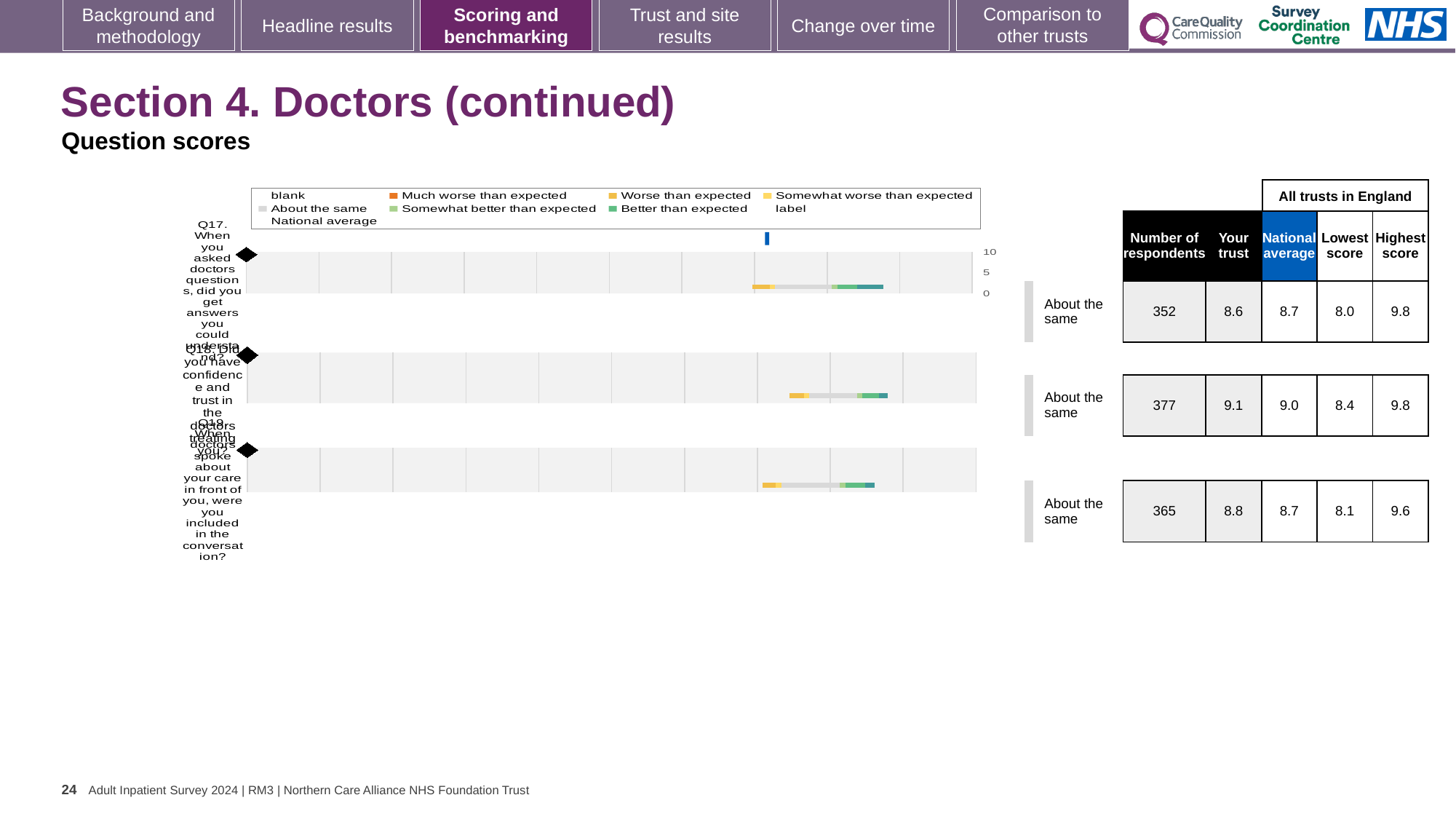
What benchmark category is given for Q17 (When you asked doctors questions, did you get answers you could understand?)? About the same Which question has the highest 'Your trust' score? Q18 What is the 'Your trust' score for Q18 (Did you have confidence and trust in the doctors treating you?)? 9.1 What is the difference between the 'Your trust' score and the national average for Q18? 0.1 What is the national average score for Q19 (When doctors spoke about your care in front of you, were you included in the conversation?)? 8.7 How many questions (categories) are plotted in the question scores chart? 3 What kind of chart is used to show the question scores on this slide? bar chart For Q17, which is larger: the 'Your trust' score or the national average? National average Which question has the lowest 'Lowest score' across all trusts in England? Q17 What is the highest value shown on the score axis of the chart? 10 How many respondents answered Q17? 352 Which legend entry is shown in orange in the chart legend? Much worse than expected